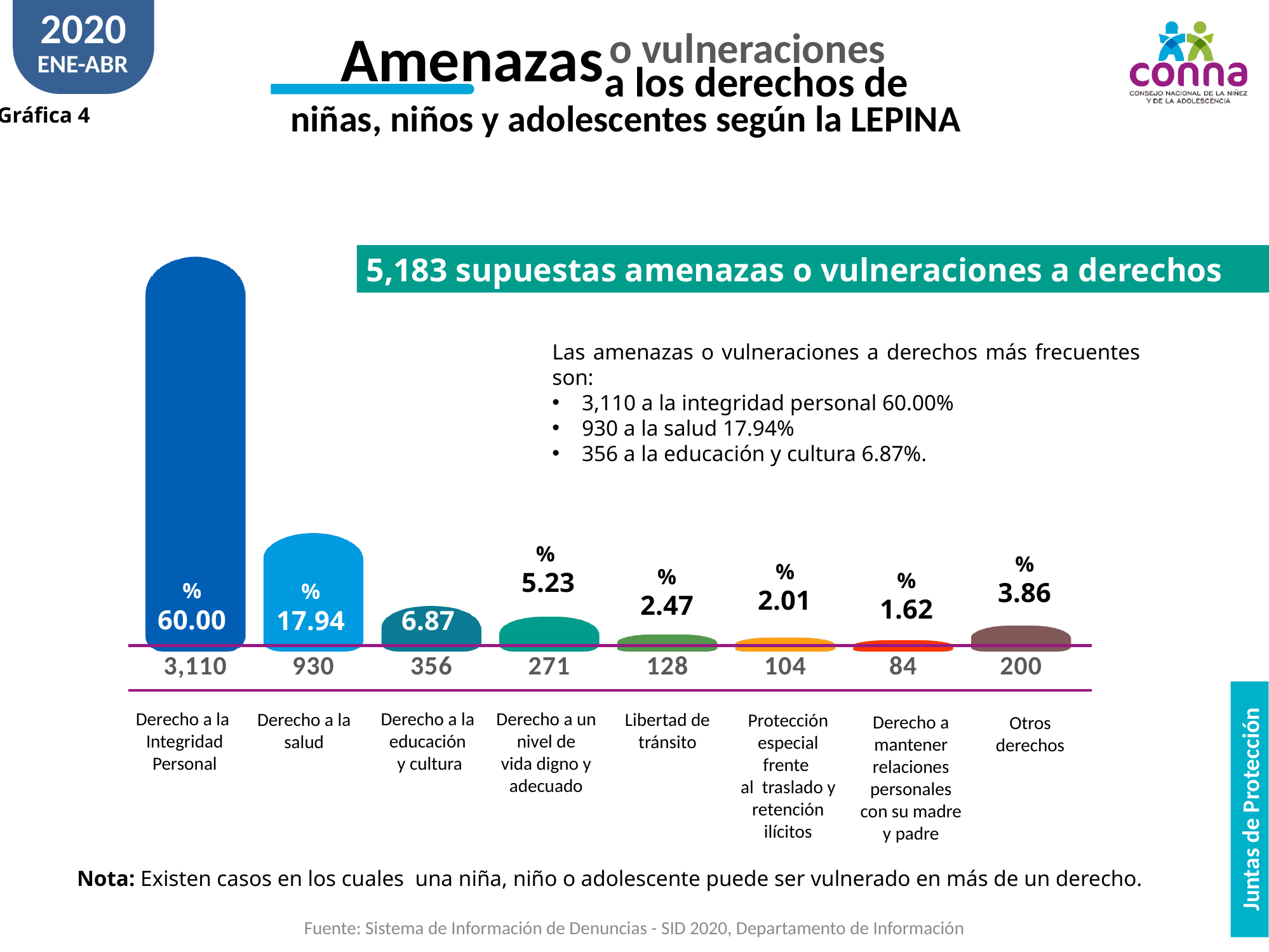
What is the difference in cases between Protección especial frente al traslado y retención ilícitos and Derecho a mantener relaciones personales con su madre y padre? 20 What is the total number of supposed threats or violations of rights stated on the slide? 5,183 How many cases are shown for Derecho a la Integridad Personal? 3,110 Which category has the lowest number of cases? Derecho a mantener relaciones personales con su madre y padre How many categories are shown in the chart? 8 How many cases are shown for Libertad de tránsito? 128 What kind of chart is shown on the slide? Bar chart What percentage is shown for Otros derechos? 3.86% Which category has the highest number of cases? Derecho a la Integridad Personal What is the difference in cases between Derecho a la salud and Derecho a la educación y cultura? 574 Which has more cases, Otros derechos or Derecho a un nivel de vida digno y adecuado? Derecho a un nivel de vida digno y adecuado What percentage is shown for Derecho a la salud? 17.94%